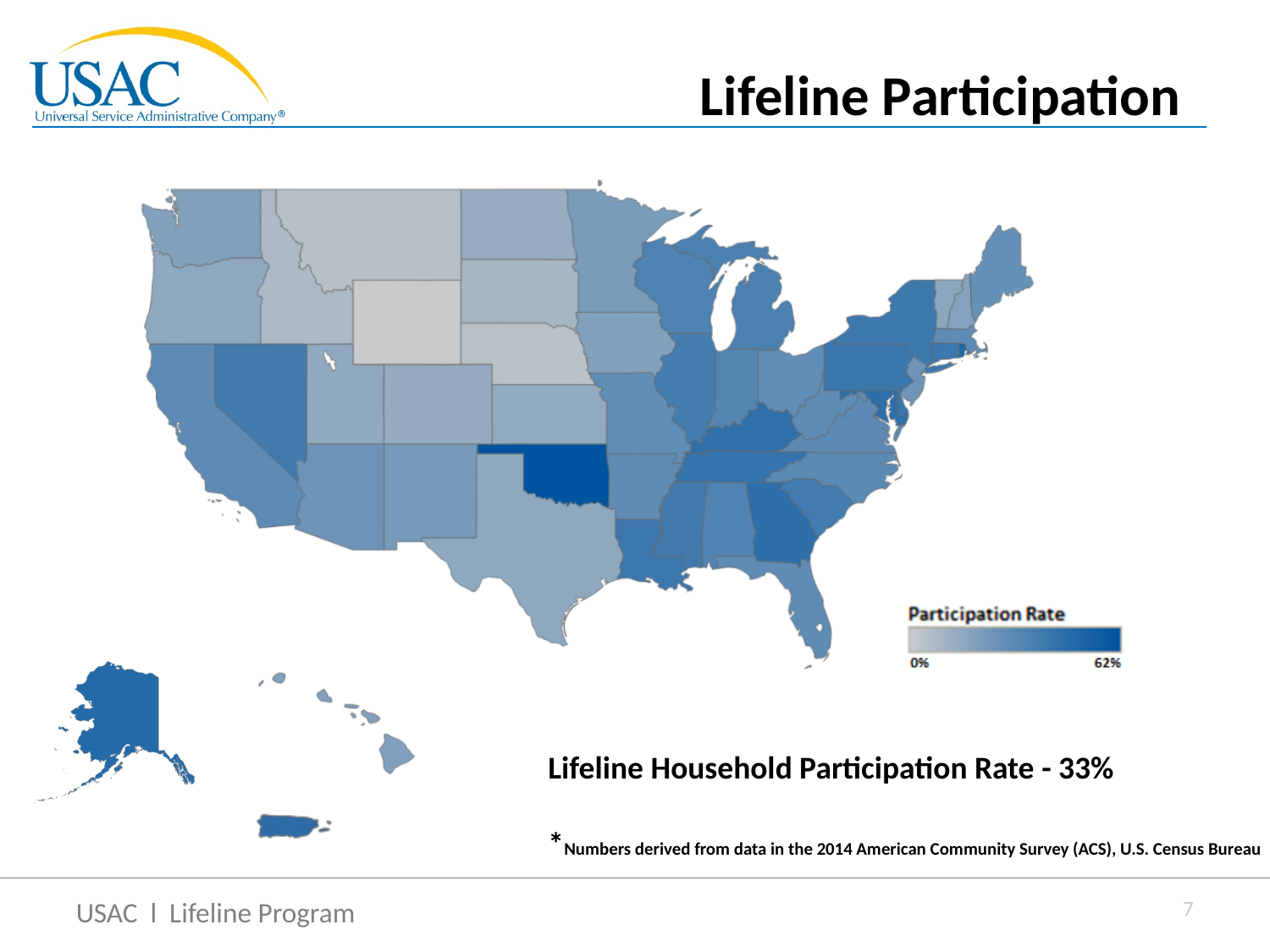
What is the highest value shown on the map's Participation Rate colour scale? 62% What kind of chart is shown on the slide? A map (choropleth map of the United States) According to the footnote, what data source are the map's numbers derived from? 2014 American Community Survey (ACS), U.S. Census Bureau What is the title of the map's colour legend? Participation Rate What is the Lifeline Household Participation Rate stated on the slide? 33% What is the lowest value shown on the map's Participation Rate colour scale? 0% Is the stated Lifeline Household Participation Rate of 33% greater or less than the 62% maximum on the legend scale? less